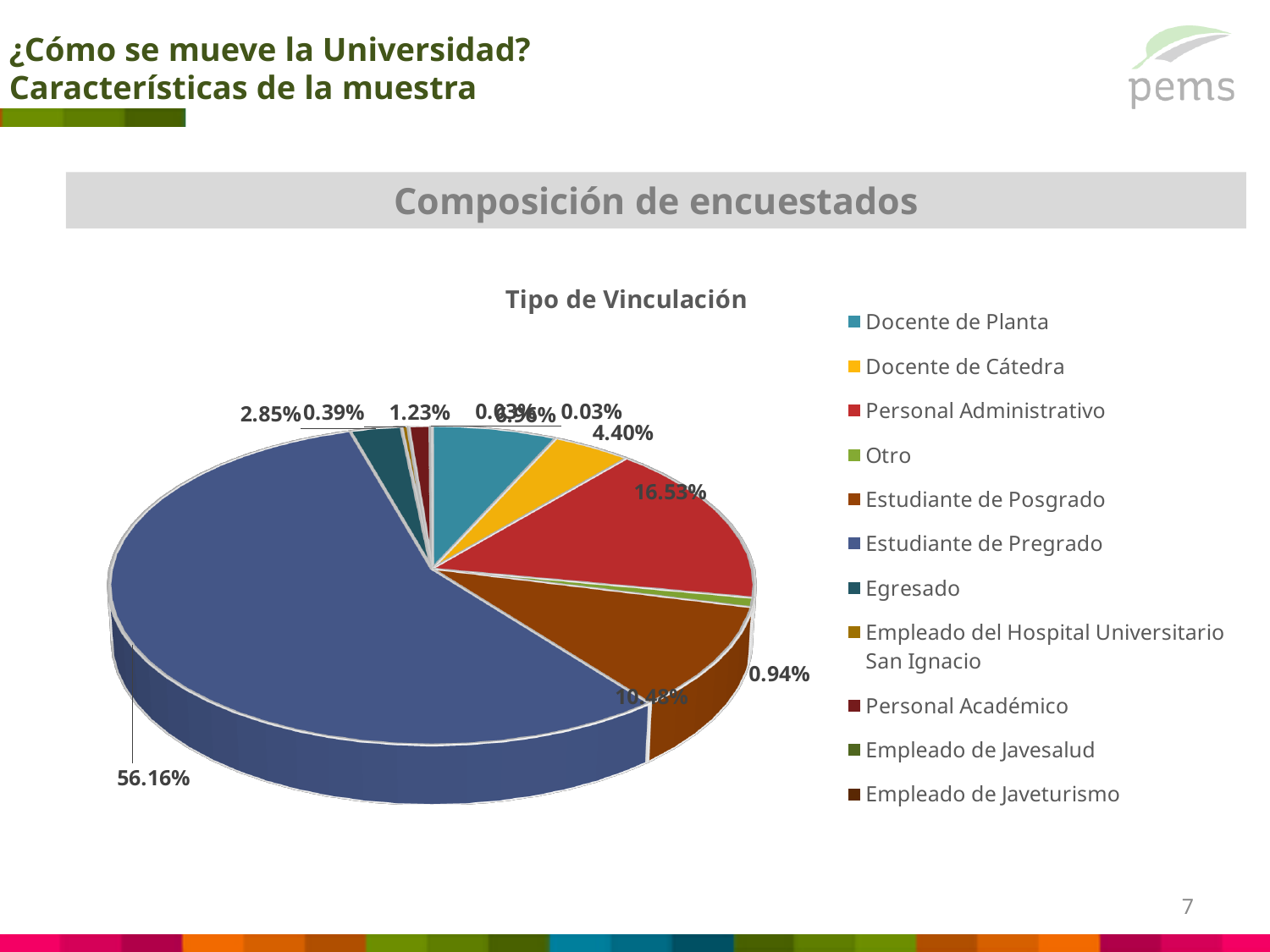
Which is larger, Docente de Cátedra or Egresado? Docente de Cátedra What is the value for Egresado? 2.85% What is the value for Estudiante de Posgrado? 10.48% What type of chart is shown on the slide? pie chart What share of the pie does Estudiante de Pregrado represent? 56.16% What is the value for Personal Administrativo? 16.53% How many categories does the legend list? 11 Which is larger, Personal Administrativo or Estudiante de Posgrado? Personal Administrativo Which category has the largest slice of the pie? Estudiante de Pregrado What is the title of the chart? Tipo de Vinculación What is the value for Docente de Cátedra? 4.40% What is the difference between the Estudiante de Pregrado and Personal Administrativo shares? 39.63%